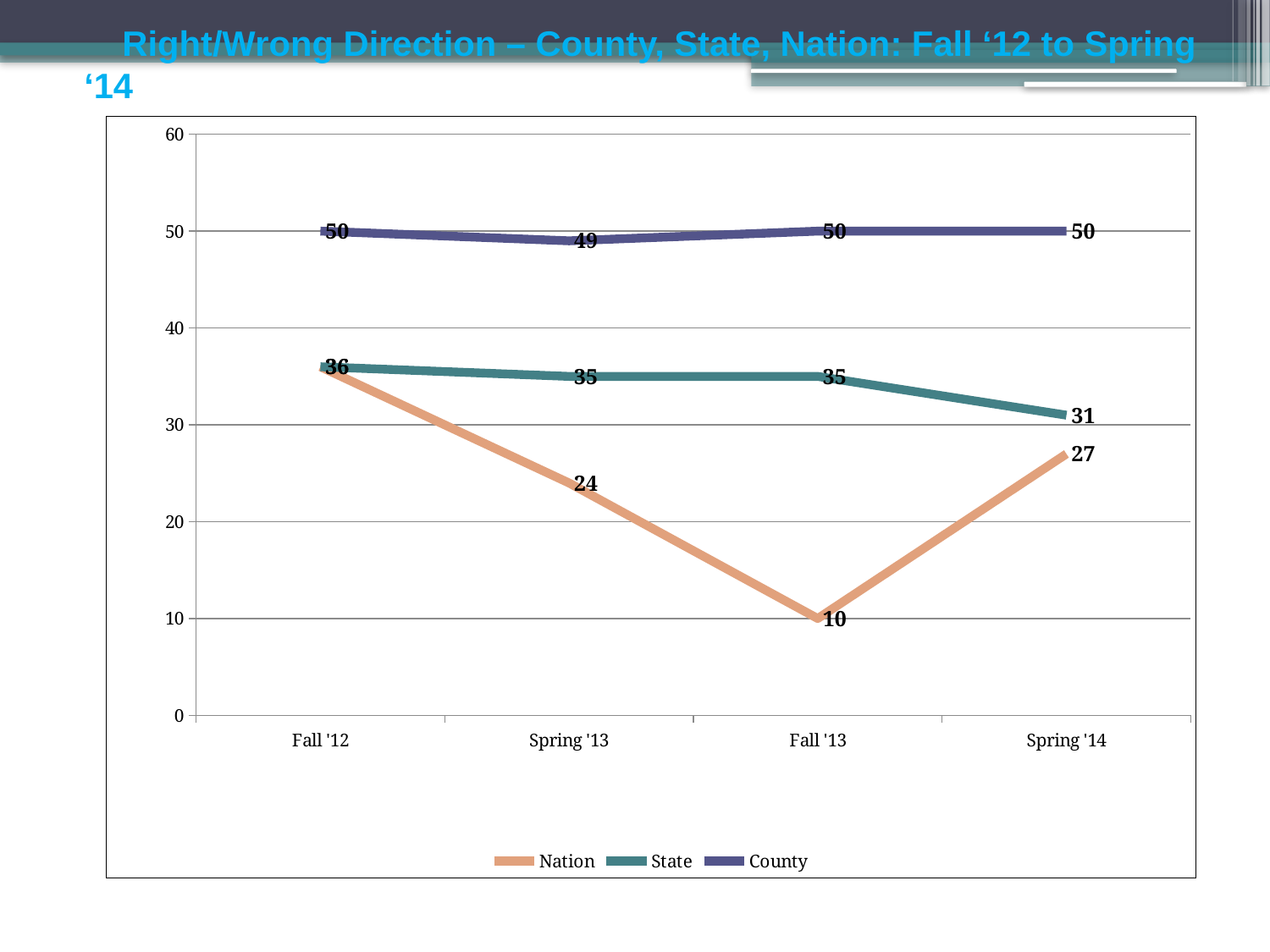
At which time point is the Nation value lowest? Fall '13 What is the value for Nation at Fall '13? 10 What kind of chart is shown on the slide? Line chart How many series does the legend list? 3 What is the difference between the State values at Fall '12 and Spring '14? 5 What is the value for State at Spring '14? 31 What is the difference between the County and Nation values at Fall '13? 40 Does the State series rise or fall from Fall '12 to Spring '14? Fall How many time points are shown on the x axis? 4 At which time point is the Nation value highest? Fall '12 What is the value for County at Spring '13? 49 Which is larger at Spring '14, the State value or the Nation value? State